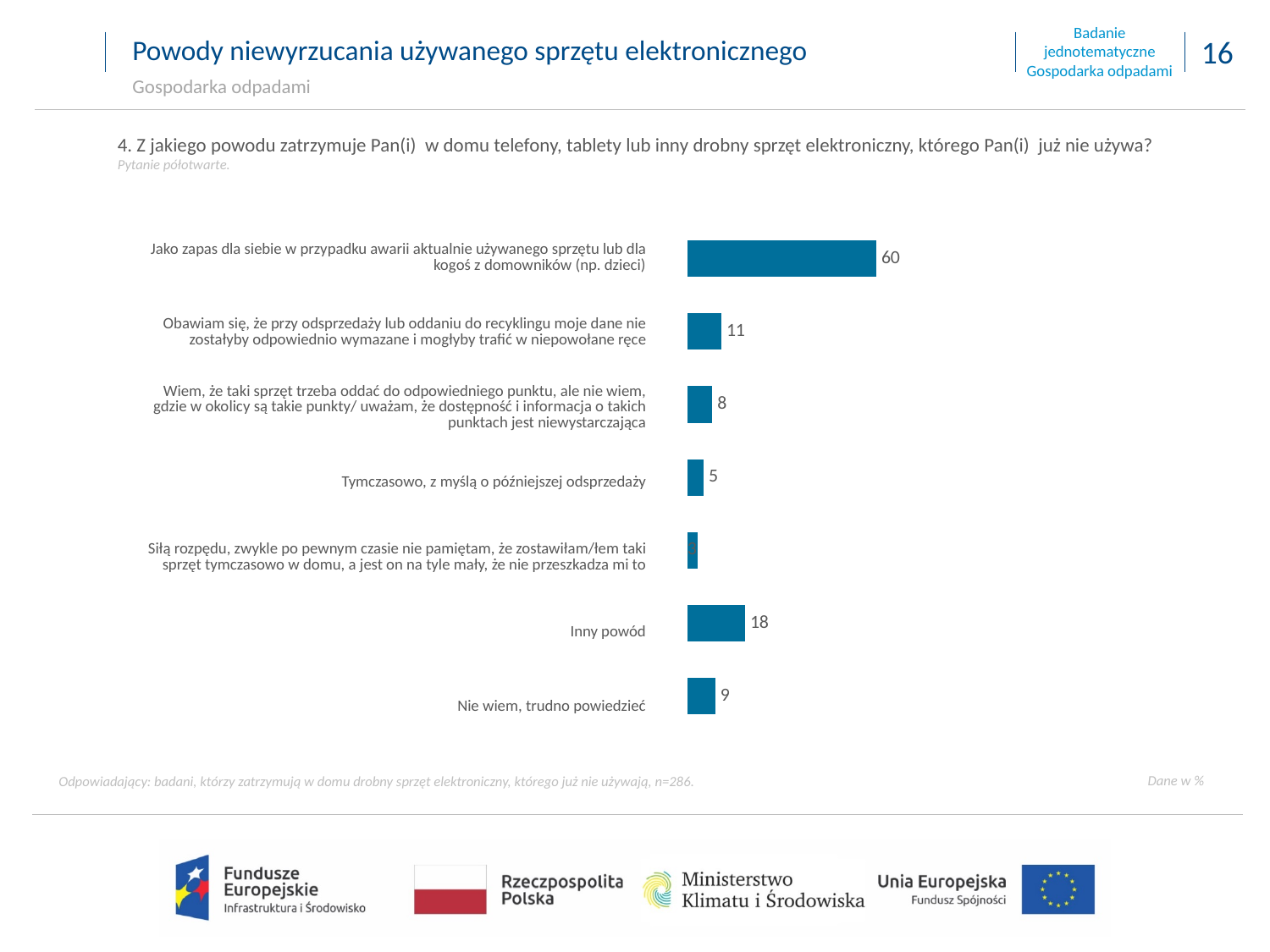
What is the value for "Inny powód"? 18 What is the difference between the value for "Jako zapas dla siebie..." (60) and the value for "Inny powód" (18)? 42 What is the title of the slide containing the chart? Powody niewyrzucania używanego sprzętu elektronicznego How many categories (reasons) are plotted in the chart? 7 Which reason has the highest value in the chart? Jako zapas dla siebie w przypadku awarii aktualnie używanego sprzętu lub dla kogoś z domowników (np. dzieci) Which reason has the lowest value in the chart? Siłą rozpędu, zwykle po pewnym czasie nie pamiętam, że zostawiłam/łem taki sprzęt tymczasowo w domu, a jest on na tyle mały, że nie przeszkadza mi to What is the value for "Jako zapas dla siebie w przypadku awarii aktualnie używanego sprzętu lub dla kogoś z domowników (np. dzieci)"? 60 Which is larger: the value for "Inny powód" or the value for "Nie wiem, trudno powiedzieć"? Inny powód What is the value for "Nie wiem, trudno powiedzieć"? 9 What is the value for "Tymczasowo, z myślą o późniejszej odsprzedaży"? 5 What is the value for "Obawiam się, że przy odsprzedaży lub oddaniu do recyklingu moje dane nie zostałyby odpowiednio wymazane i mogłyby trafić w niepowołane ręce"? 11 What type of chart is shown on the slide? bar chart